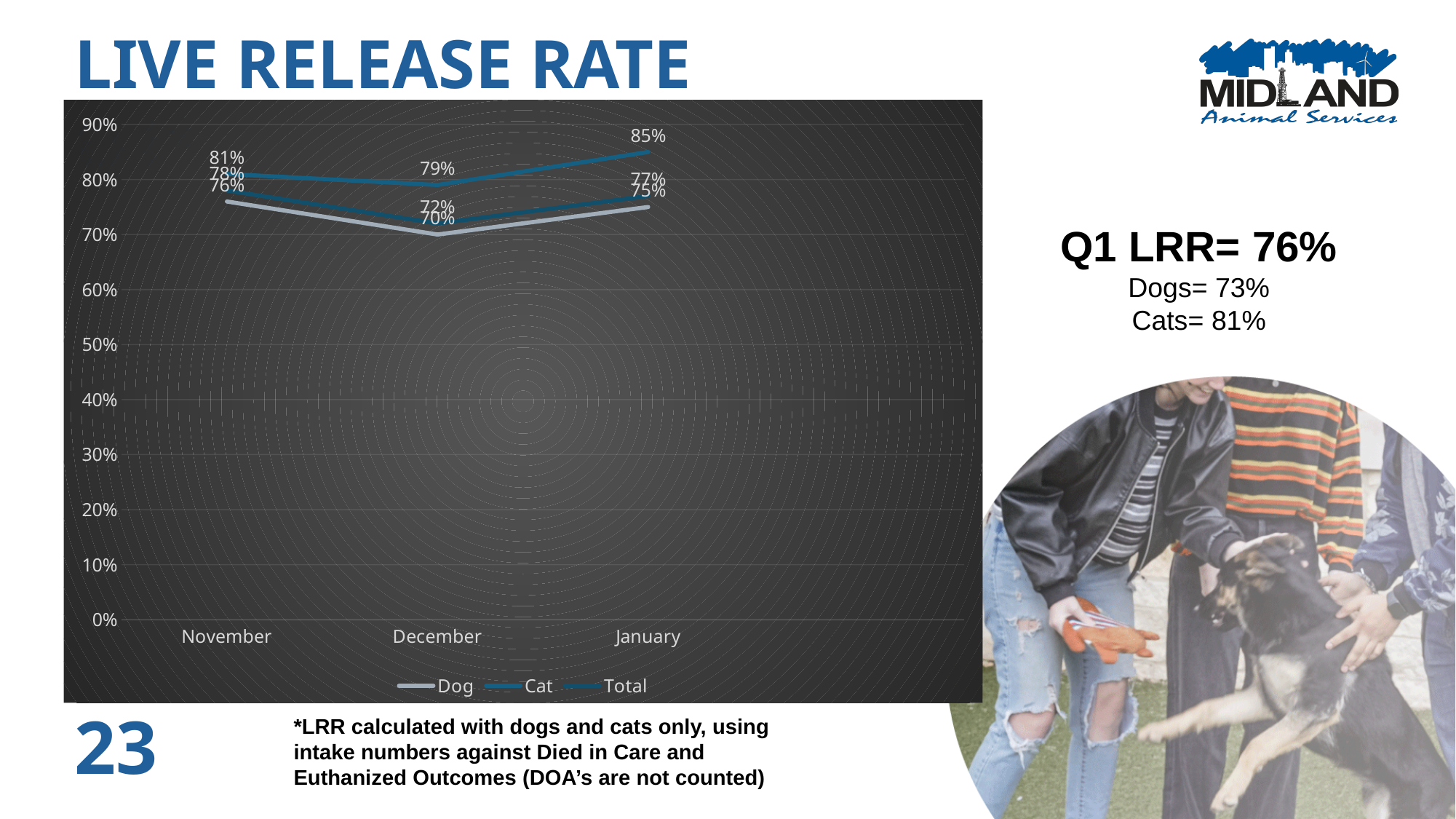
What is the Cat live release rate in January? 85% Which is higher in December, the Cat rate or the Total rate? Cat Does the Dog live release rate rise or fall from November to December? fall In which month is the Cat live release rate highest? January What is the Dog live release rate in December? 70% What is the difference between the Cat and Dog live release rates in January? 10% How many months are shown on the x axis of the chart? 3 In which month is the Dog live release rate lowest? December How many series does the chart legend list? 3 What is the Total live release rate in November? 78% What kind of chart is shown on the slide? line chart Which series is drawn with the light gray line in the chart? Dog